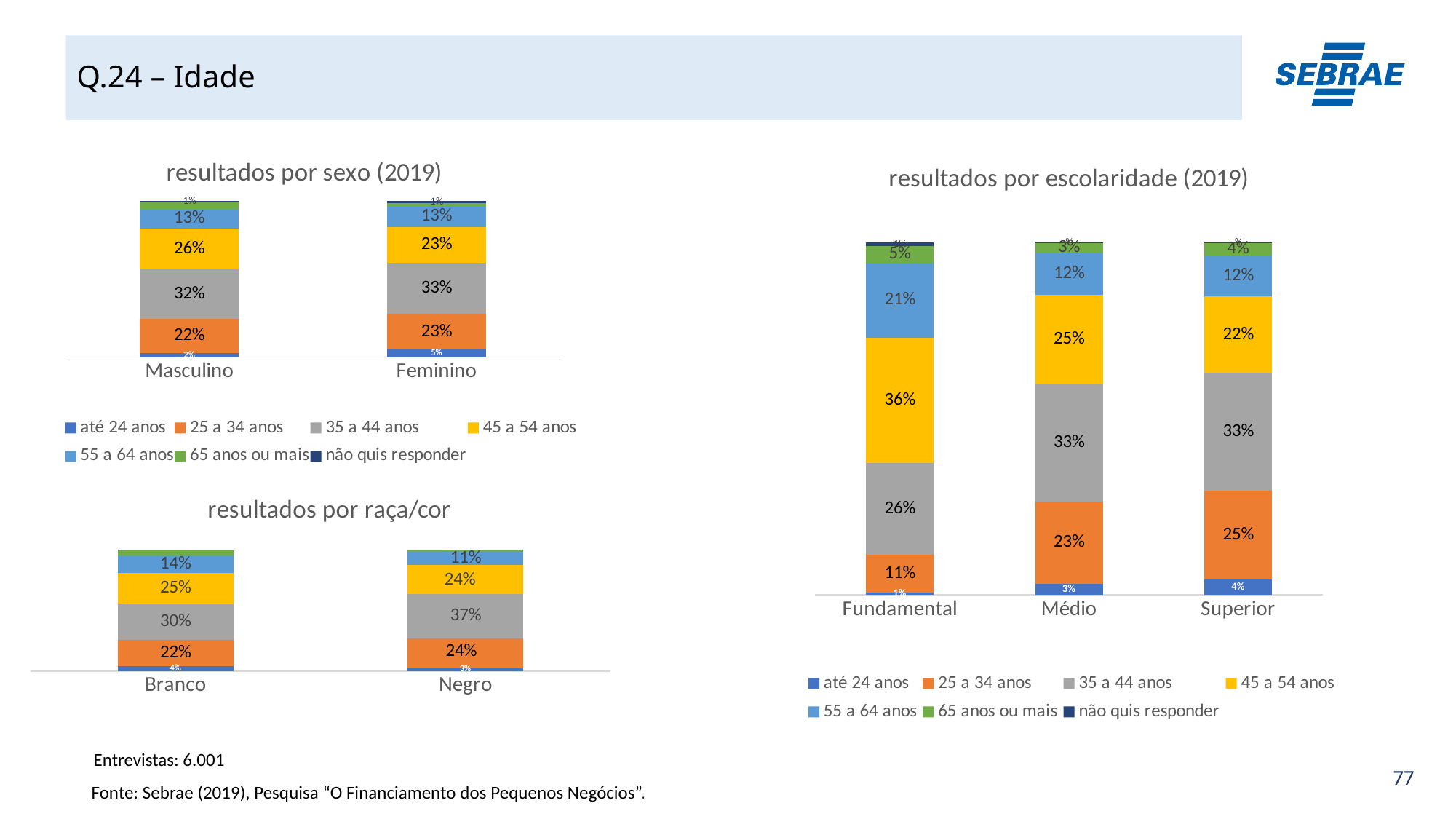
In the 'resultados por sexo (2019)' chart, what is the value of the '45 a 54 anos' segment for Feminino? 23% In the 'resultados por escolaridade (2019)' chart, which category has the lowest '25 a 34 anos' value? Fundamental In the 'resultados por sexo (2019)' chart, what is the value of the '35 a 44 anos' segment for Masculino? 32% In the 'resultados por escolaridade (2019)' chart, which category has the highest '55 a 64 anos' value? Fundamental In the 'resultados por raça/cor' chart, which category has the larger '55 a 64 anos' value, Branco or Negro? Branco How many series does the legend of the 'resultados por escolaridade (2019)' chart list? 7 In the 'resultados por sexo (2019)' chart, what is the difference between the '45 a 54 anos' values for Masculino and Feminino? 3 percentage points How many categories are shown on the x axis of the 'resultados por escolaridade (2019)' chart? 3 In the 'resultados por raça/cor' chart, what is the difference between the '35 a 44 anos' values for Negro and Branco? 7 percentage points In the 'resultados por escolaridade (2019)' chart, what is the value of the '45 a 54 anos' segment for Fundamental? 36% What type of chart is the 'resultados por raça/cor' chart? Stacked bar chart In the 'resultados por raça/cor' chart, what is the value of the '35 a 44 anos' segment for Negro? 37%